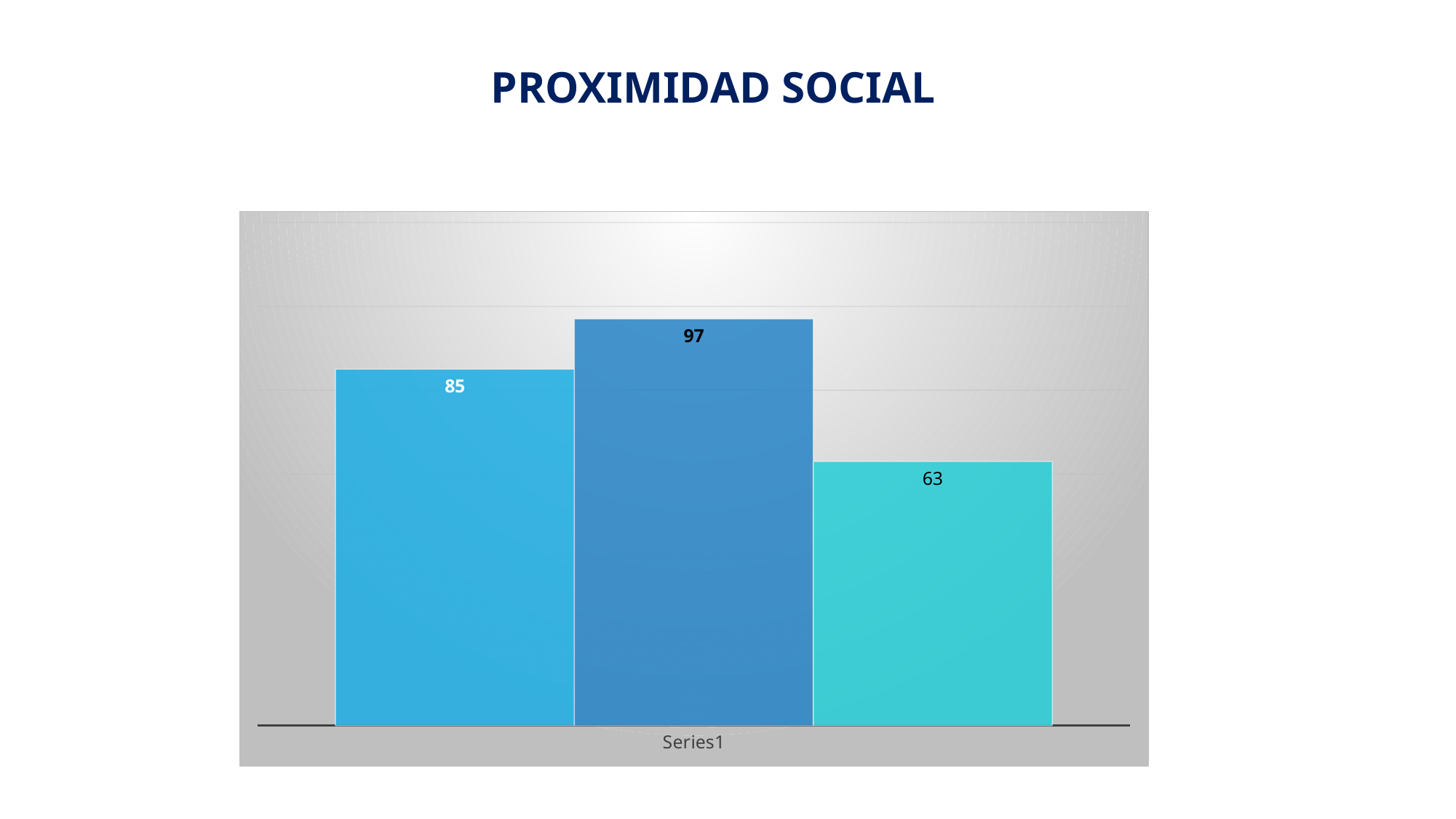
What is the difference between the left bar and the right bar? 22 What label appears on the x axis below the bars? Series1 Which is larger, the left bar or the right bar? the left bar What is the value of the middle (dark blue) bar? 97 Which bar has the lowest value? the right (turquoise) bar What is the title of the slide? PROXIMIDAD SOCIAL What type of chart is shown on the slide? bar chart What is the value of the right (turquoise) bar? 63 What is the value of the left (light blue) bar? 85 How many bars are plotted in the chart? 3 What is the difference between the middle bar and the left bar? 12 Which bar has the highest value? the middle (dark blue) bar